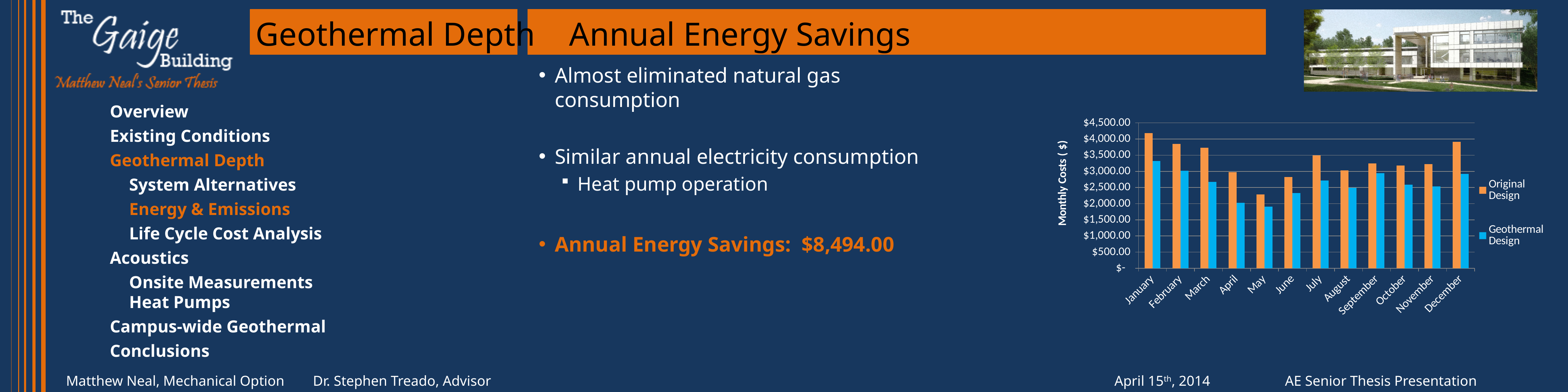
For the Original Design series, which month has the larger monthly cost, February or July? February Is the Original Design value for December greater or less than $3,500.00? greater In January, which series has the larger monthly cost, Original Design or Geothermal Design? Original Design In which month is the Geothermal Design monthly cost lowest? May In which month is the Original Design monthly cost highest? January What is the title of the chart's vertical axis? Monthly Costs ( $) Is the Original Design value for January greater or less than $4,000.00? greater How many series does the chart's legend list? 2 In which month is the Original Design monthly cost lowest? May What kind of chart is shown on the slide? Bar chart How many months are shown on the x axis of the chart? 12